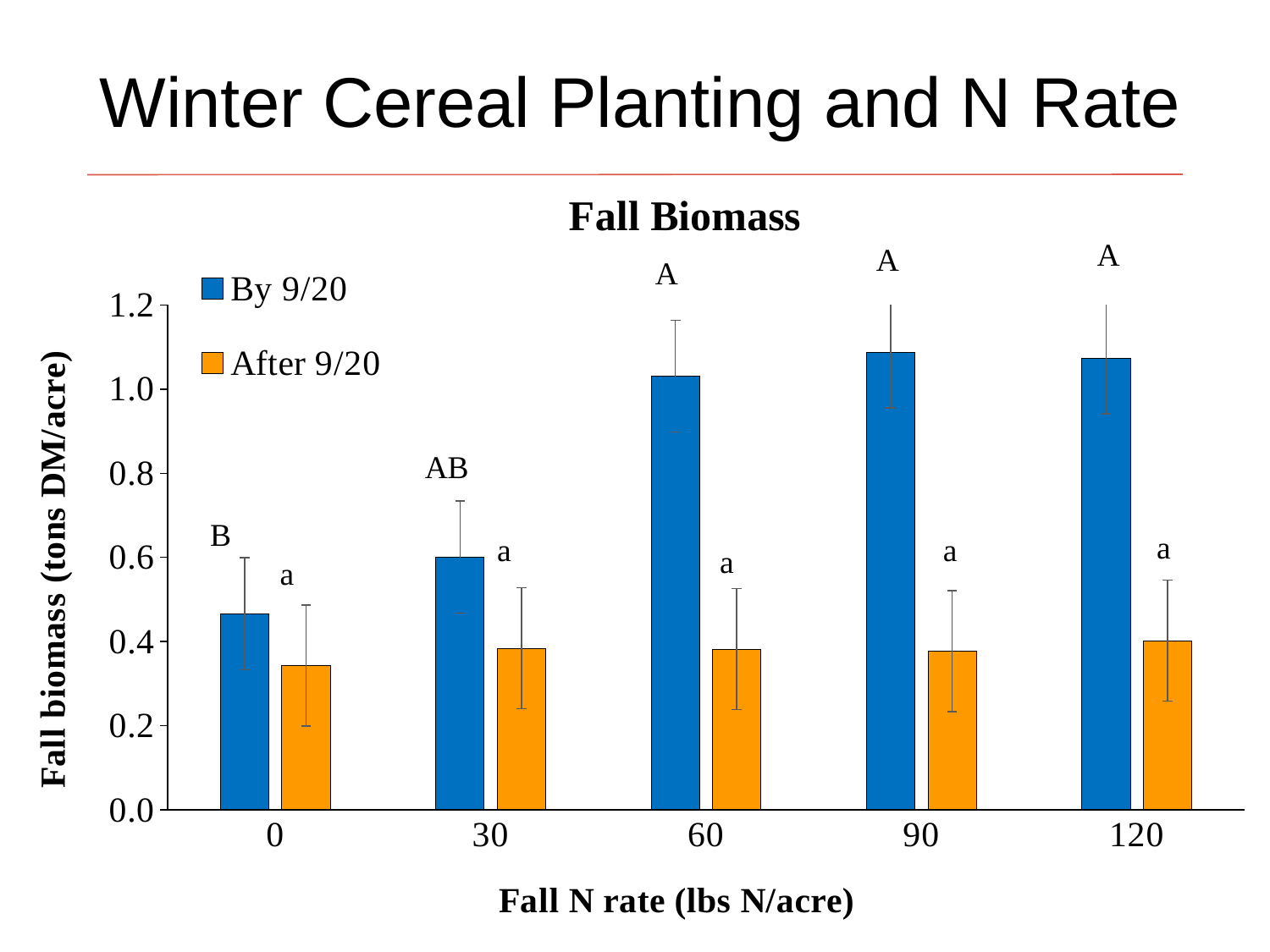
What is the title of the chart? Fall Biomass Is the After 9/20 value at a fall N rate of 0 greater or less than 0.4? less How many series does the legend list? 2 Is the After 9/20 value at a fall N rate of 120 greater or less than 0.2? greater What kind of chart is shown on the slide? bar chart For the By 9/20 series, which is larger: the value at a fall N rate of 30 or at 60? 60 Is the By 9/20 value at a fall N rate of 30 greater or less than 0.8? less For the By 9/20 series, at which fall N rate is the value lowest? 0 How many fall N rate categories are shown on the x axis? 5 Does the By 9/20 series generally rise or fall as the fall N rate increases from 0 to 90? rise At a fall N rate of 60, which series has the larger value, By 9/20 or After 9/20? By 9/20